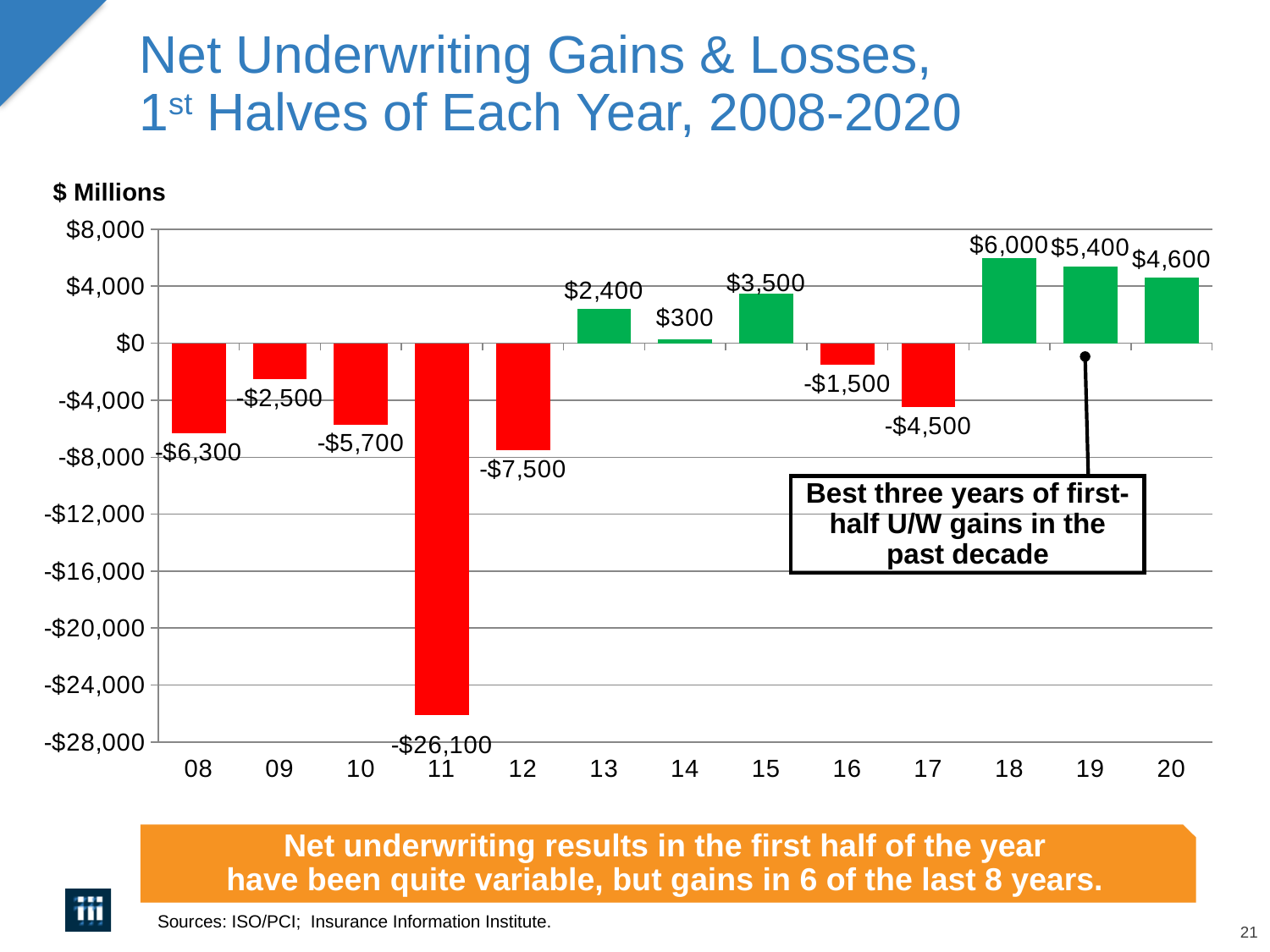
What is the net underwriting result for the first half of 2011? -$26,100 What kind of chart is shown on the slide? Bar chart Which year has the larger value, 2015 or 2013? 2015 What unit is indicated above the y axis? $ Millions Is the value for 2012 greater or less than -$4,000? less What is the net underwriting gain for the first half of 2018? $6,000 What is the value shown for 2014? $300 What is the difference between the 2018 value and the 2020 value? $1,400 How many years show a negative net underwriting result? 7 Which year has the lowest net underwriting result? 11 Which year has the highest net underwriting gain? 18 How many years are shown on the x axis? 13